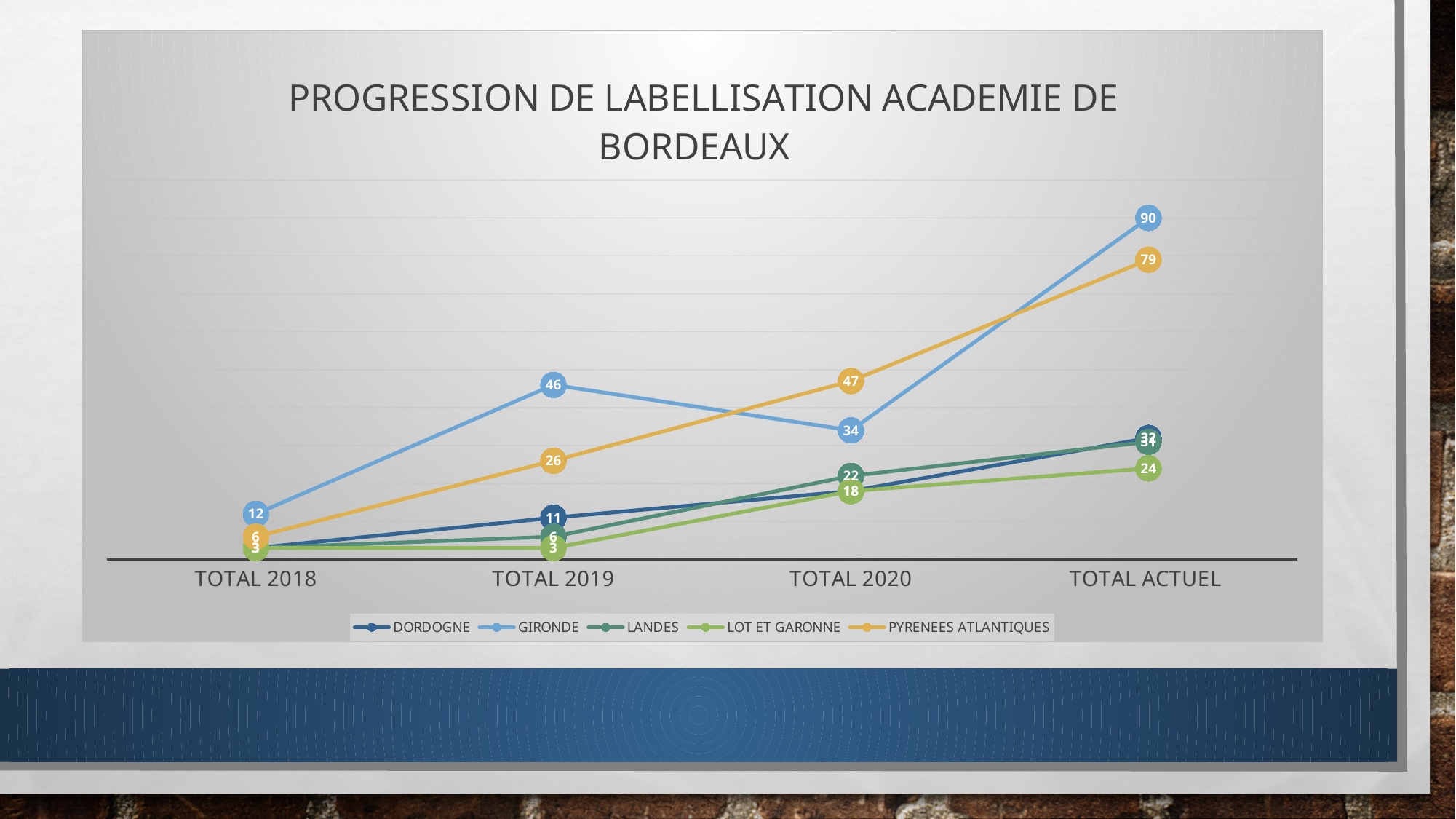
Does the PYRENEES ATLANTIQUES series rise or fall from TOTAL 2018 to TOTAL ACTUEL? rise What is the value for PYRENEES ATLANTIQUES at TOTAL 2020? 47 What is the difference between GIRONDE and PYRENEES ATLANTIQUES at TOTAL ACTUEL? 11 What is the value for GIRONDE at TOTAL ACTUEL? 90 What is the value for LOT ET GARONNE at TOTAL 2020? 18 How many categories are shown on the x axis? 4 What is the value for GIRONDE at TOTAL 2019? 46 Which series has the highest value at TOTAL ACTUEL? GIRONDE At TOTAL 2020, which is larger: GIRONDE or PYRENEES ATLANTIQUES? PYRENEES ATLANTIQUES What is the value for DORDOGNE at TOTAL 2019? 11 What kind of chart is shown on the slide? line chart How many series does the legend list? 5